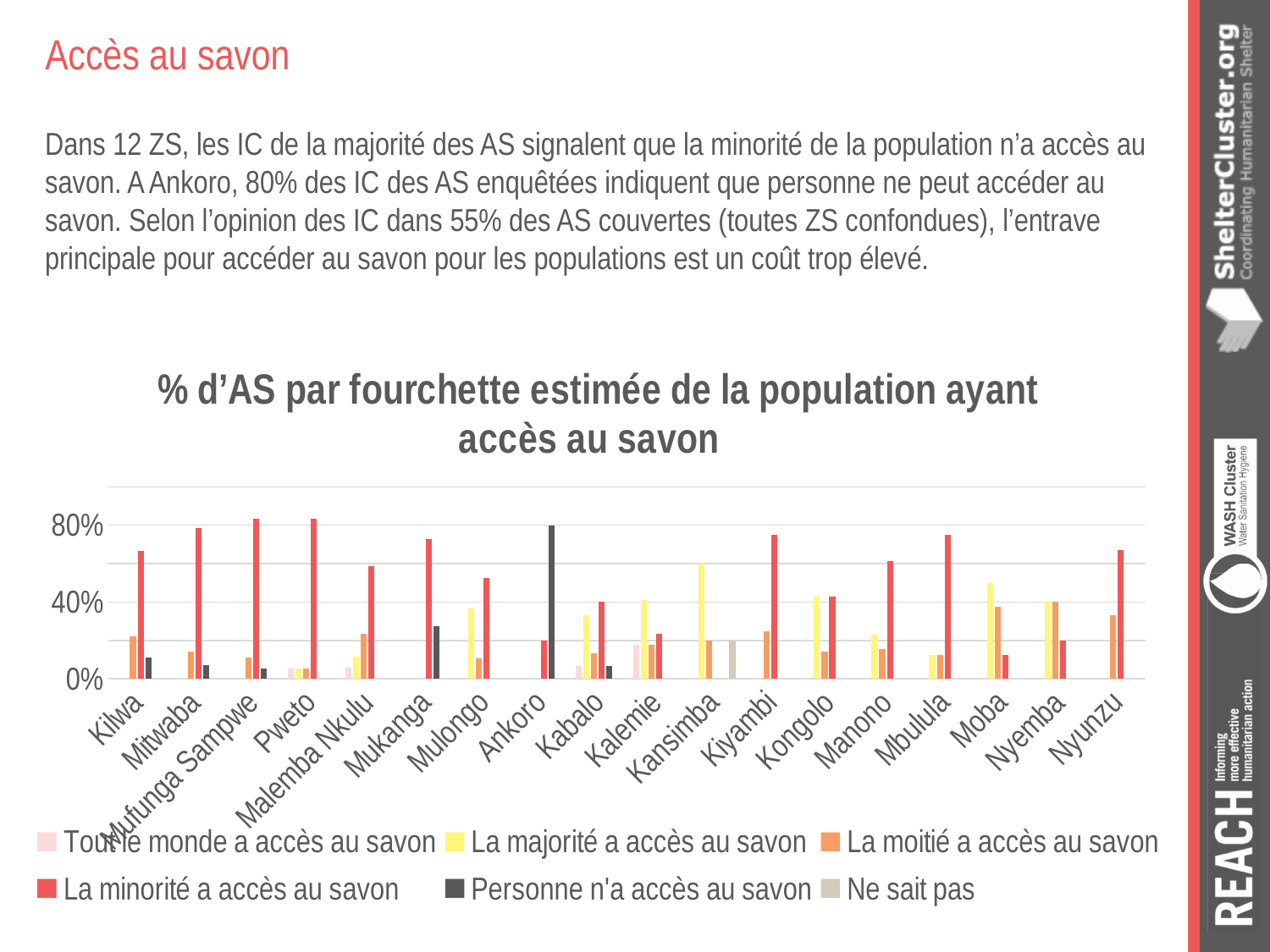
Which is larger: the 'La minorité a accès au savon' value for Mukanga or for Nyemba? Mukanga What kind of chart is shown on the slide? bar chart Is the value for 'La minorité a accès au savon' in Kilwa greater or less than 40%? greater Is the value for 'La minorité a accès au savon' in Kiyambi greater or less than 80%? less Is the value for 'La minorité a accès au savon' in Nyemba greater or less than 40%? less What is the title of the chart? % d'AS par fourchette estimée de la population ayant accès au savon Which zone has the highest value for 'Personne n'a accès au savon'? Ankoro How many zones (categories) are shown along the x axis of the chart? 18 Which zone has the highest value for 'La majorité a accès au savon'? Kansimba How many series does the chart legend list? 6 Which legend entry is shown in black? Personne n'a accès au savon In Ankoro, which is larger: 'Personne n'a accès au savon' or 'La minorité a accès au savon'? Personne n'a accès au savon